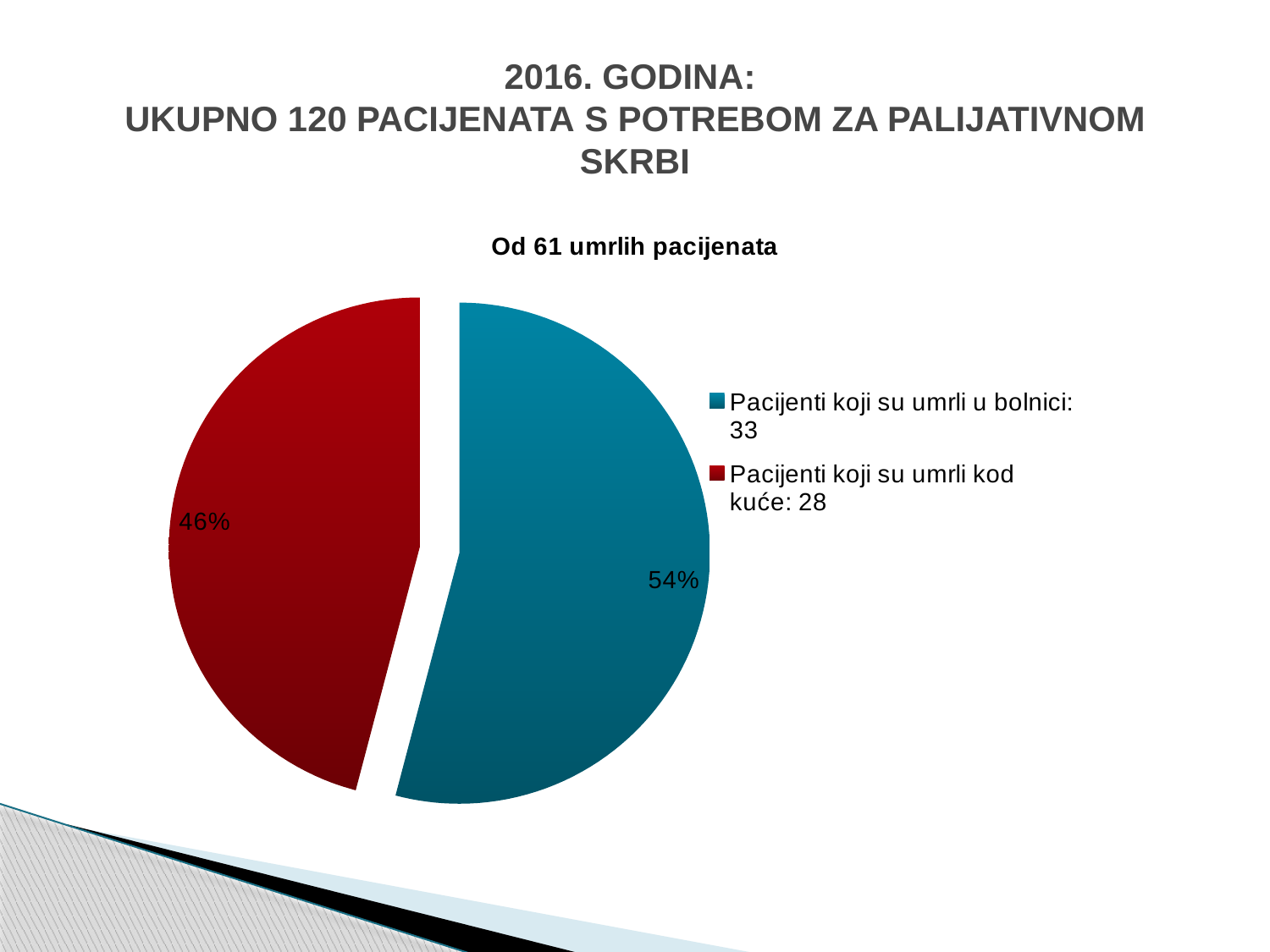
What is the difference between the number of patients who died in hospital and those who died at home? 5 What percentage share is shown for the slice 'Pacijenti koji su umrli kod kuće'? 46% How many slices does the pie chart have? 2 How many patients died at home ('Pacijenti koji su umrli kod kuće') according to the legend? 28 How many entries does the legend list? 2 Which slice is the largest? Pacijenti koji su umrli u bolnici What kind of chart is shown on the slide? pie chart How many patients died in hospital ('Pacijenti koji su umrli u bolnici') according to the legend? 33 Which slice is the smallest? Pacijenti koji su umrli kod kuće What percentage share is shown for the slice 'Pacijenti koji su umrli u bolnici'? 54% Which colour represents 'Pacijenti koji su umrli kod kuće'? red What is the title of the chart? Od 61 umrlih pacijenata